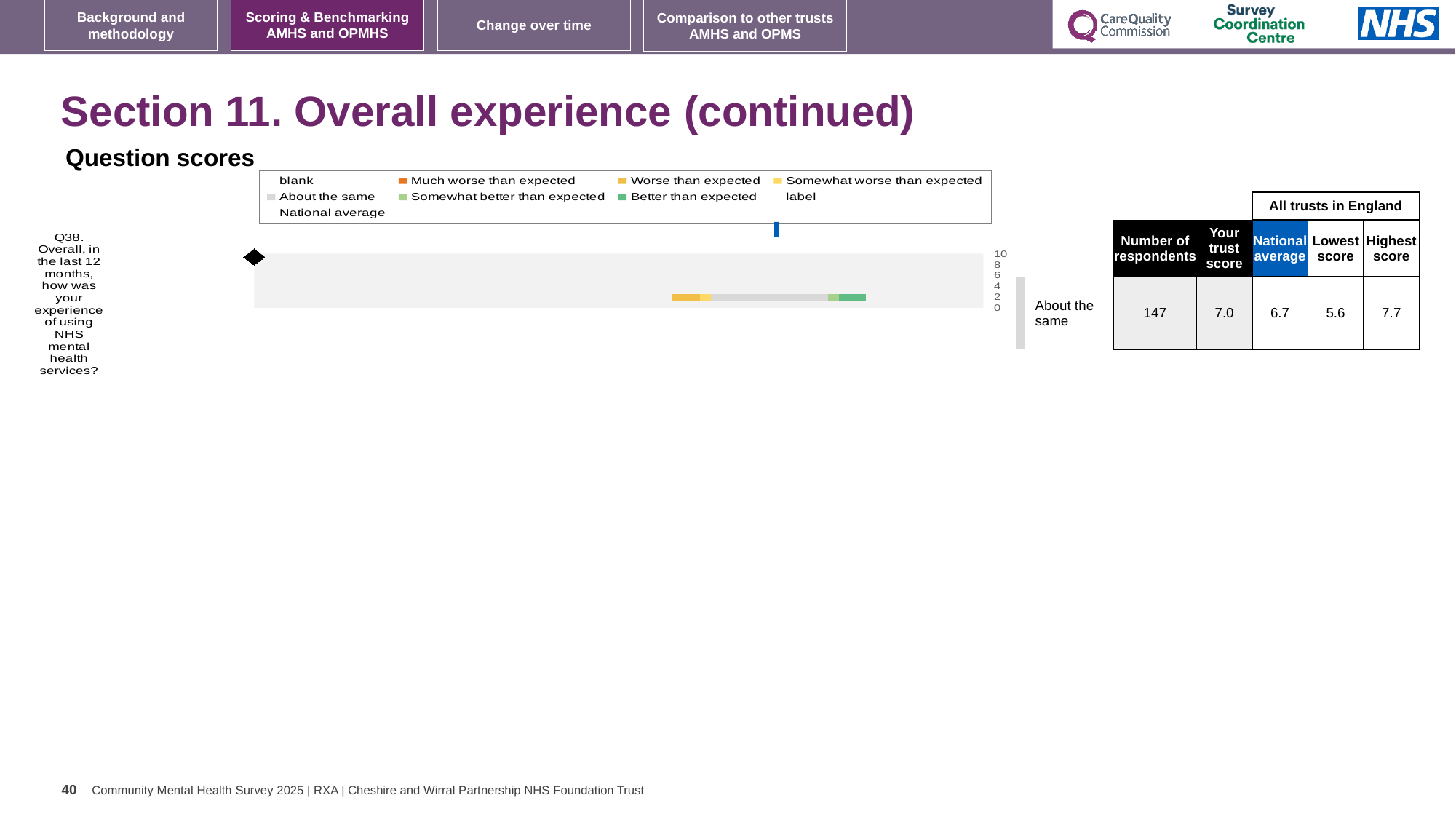
What kind of chart is used to show the Q38 question score? bar chart What is the highest value shown on the chart's axis? 10 What is the lowest score among all trusts in England for Q38? 5.6 What is the difference between the highest and lowest scores among all trusts in England for Q38? 2.1 How many respondents answered Q38? 147 What is the trust's score for Q38? 7.0 What is the national average score for Q38? 6.7 What is the highest score among all trusts in England for Q38? 7.7 How many survey questions are plotted on the chart? 1 Which is larger for Q38, the trust score or the national average? the trust score Which question is plotted on the chart? Q38. Overall, in the last 12 months, how was your experience of using NHS mental health services? Which benchmark category is the trust's Q38 score placed in? About the same